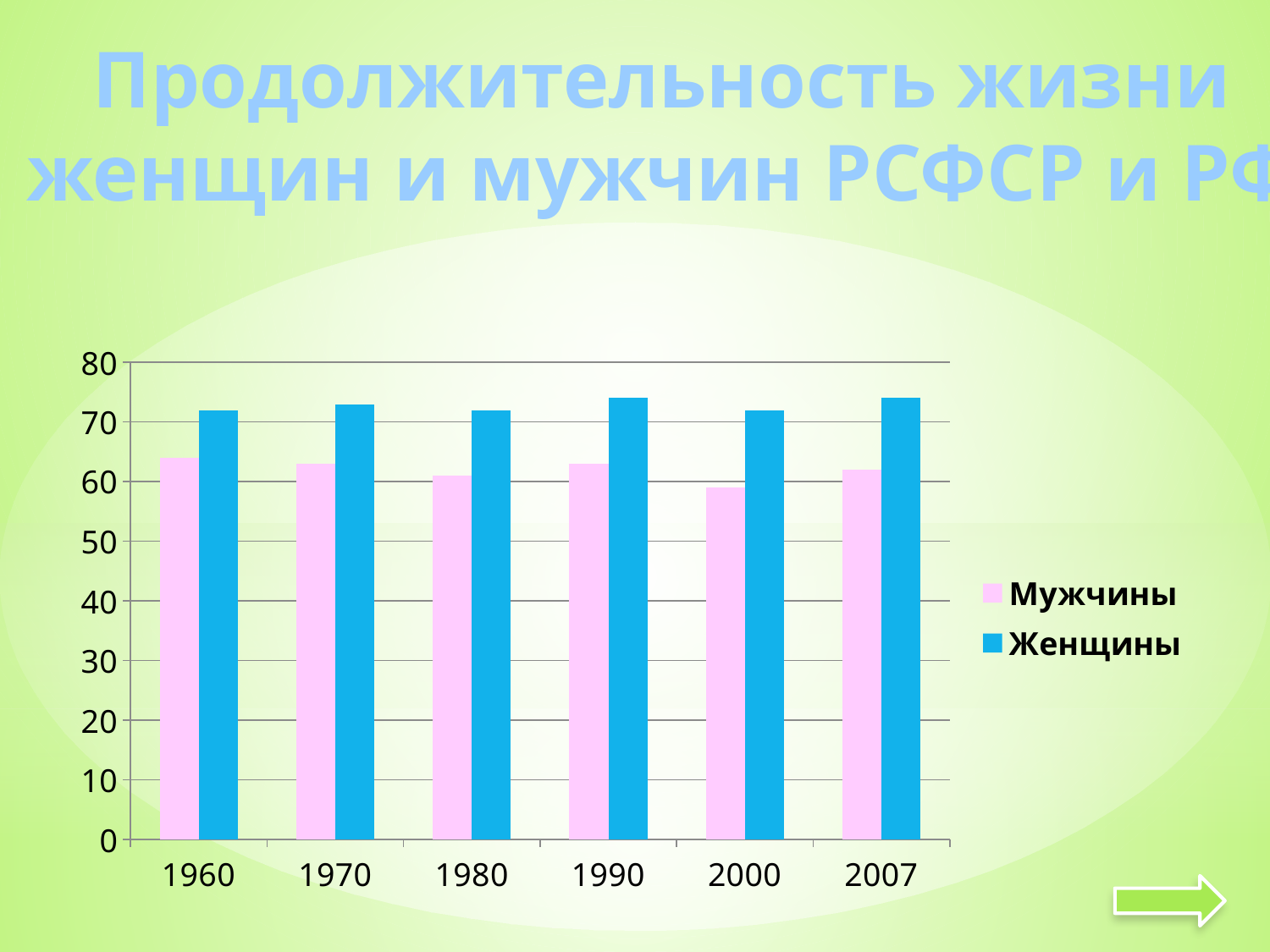
Is the value for Женщины in 1970 greater or less than 80? less For Мужчины, which is larger: the value in 1960 or in 2000? 1960 Which series are listed in the chart legend? Мужчины, Женщины Is the value for Женщины in 2007 greater or less than 70? greater In 1990, which is larger: the value for Мужчины or for Женщины? Женщины What colour are the bars for Женщины? blue How many series does the chart legend list? 2 How many years are shown on the x axis of the chart? 6 Is the value for Мужчины in 1960 greater or less than 70? less What kind of chart is shown on the slide? bar chart In which year is the value for Мужчины the lowest? 2000